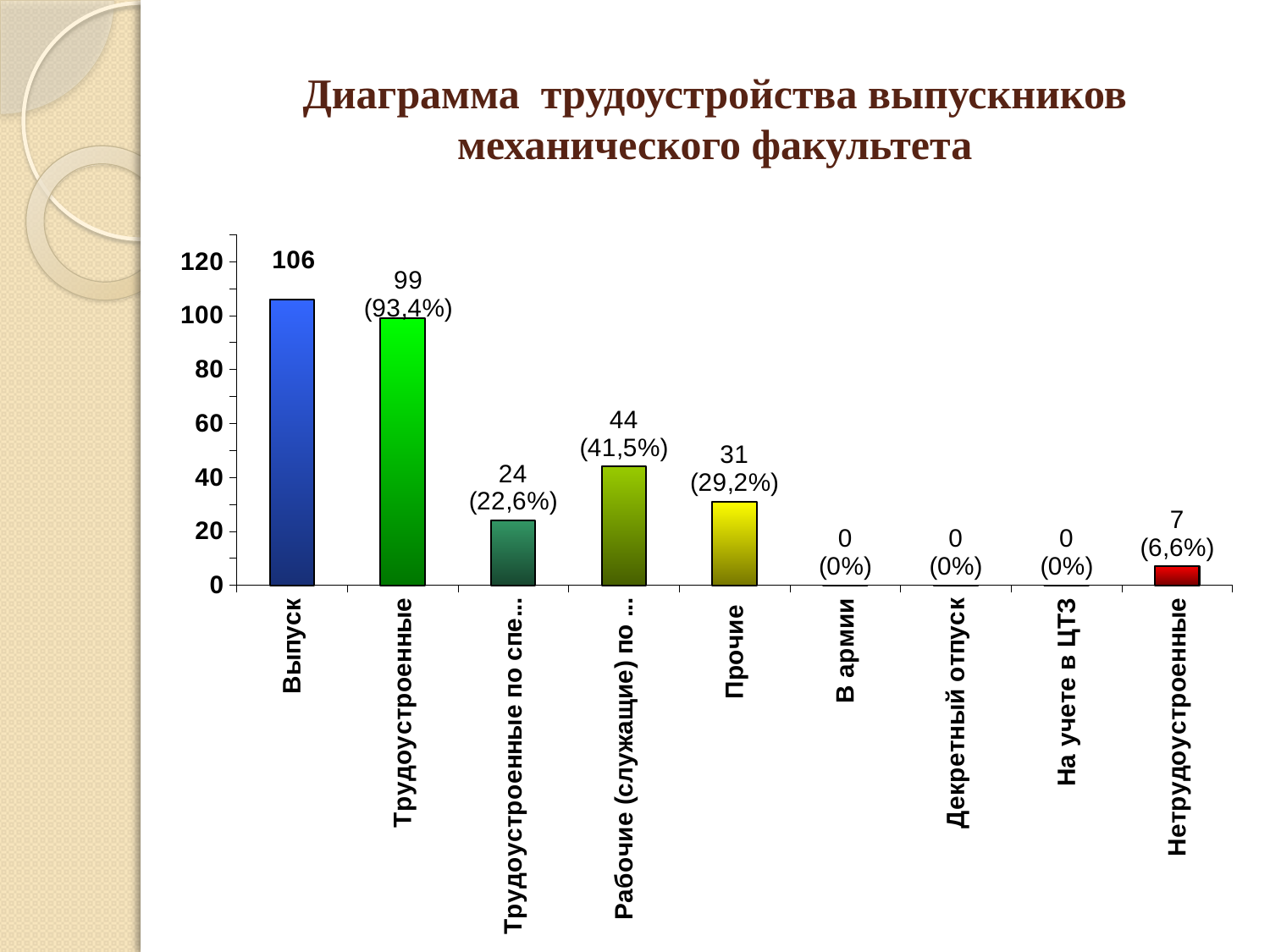
What is the value for Прочие? 31 What is the value for Трудоустроенные? 99 What is the difference between the values for Выпуск and Трудоустроенные? 7 What is the value for Нетрудоустроенные? 7 What is the value for Выпуск? 106 How many categories are shown on the x axis? 9 What percentage is shown in the data label for Нетрудоустроенные? 6,6% Which is larger, the value for Прочие or the value for Нетрудоустроенные? Прочие Which category has the highest value? Выпуск What percentage is shown in the data label for Трудоустроенные? 93,4% What kind of chart is shown on the slide? bar chart What is the value for В армии? 0